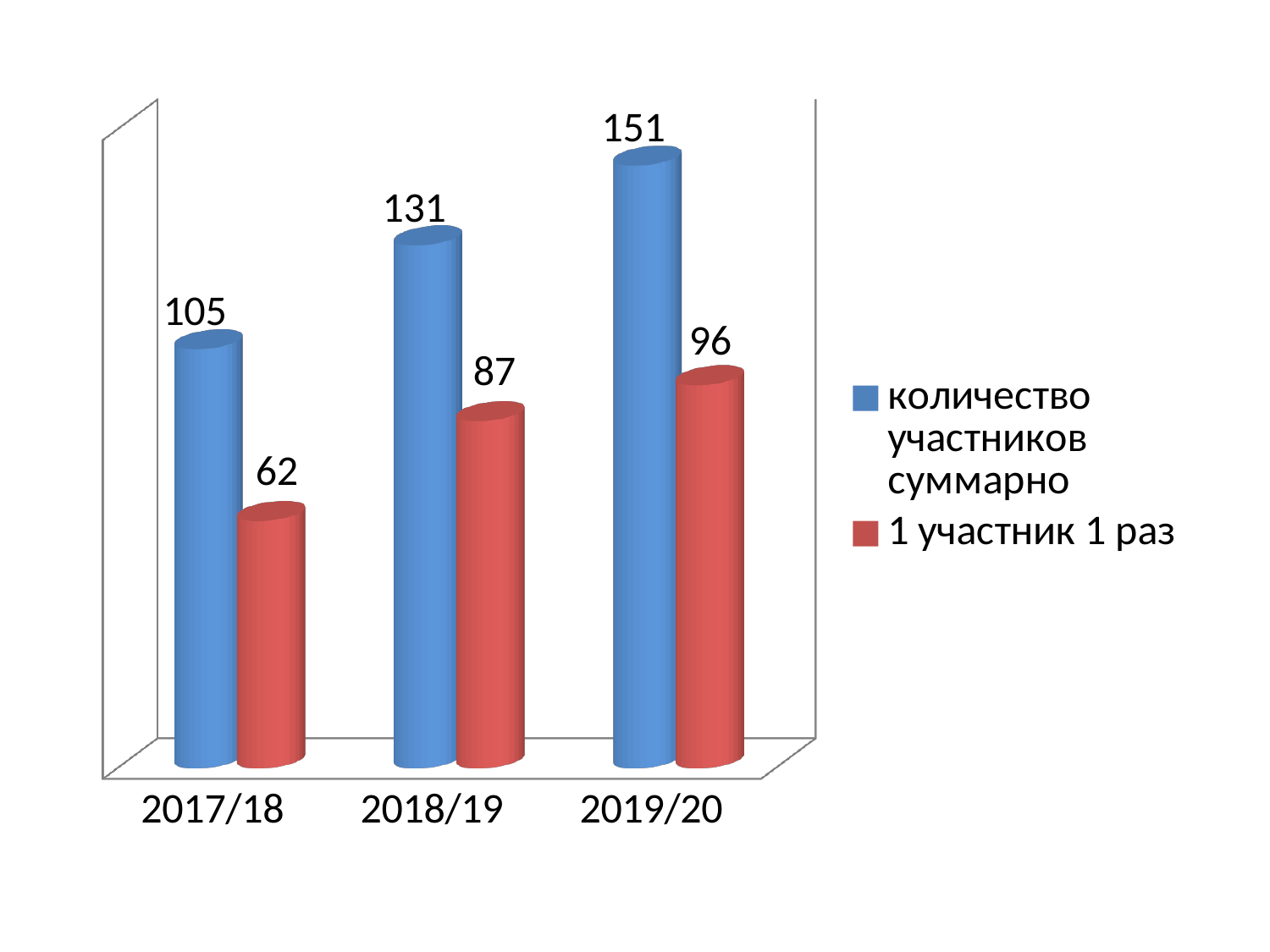
What is the difference between "количество участников суммарно" and "1 участник 1 раз" in 2019/20? 55 By how much did "количество участников суммарно" increase from 2017/18 to 2018/19? 26 Which is larger: "1 участник 1 раз" in 2019/20 or "количество участников суммарно" in 2017/18? количество участников суммарно in 2017/18 Which year has the highest value for "количество участников суммарно"? 2019/20 Which year has the lowest value for "1 участник 1 раз"? 2017/18 How many series does the legend list? 2 What is the value of "1 участник 1 раз" for 2017/18? 62 How many year categories are shown on the x axis? 3 What is the value of "количество участников суммарно" for 2019/20? 151 What kind of chart is shown on the slide? Bar chart What is the value of "1 участник 1 раз" for 2018/19? 87 What is the value of "количество участников суммарно" for 2017/18? 105